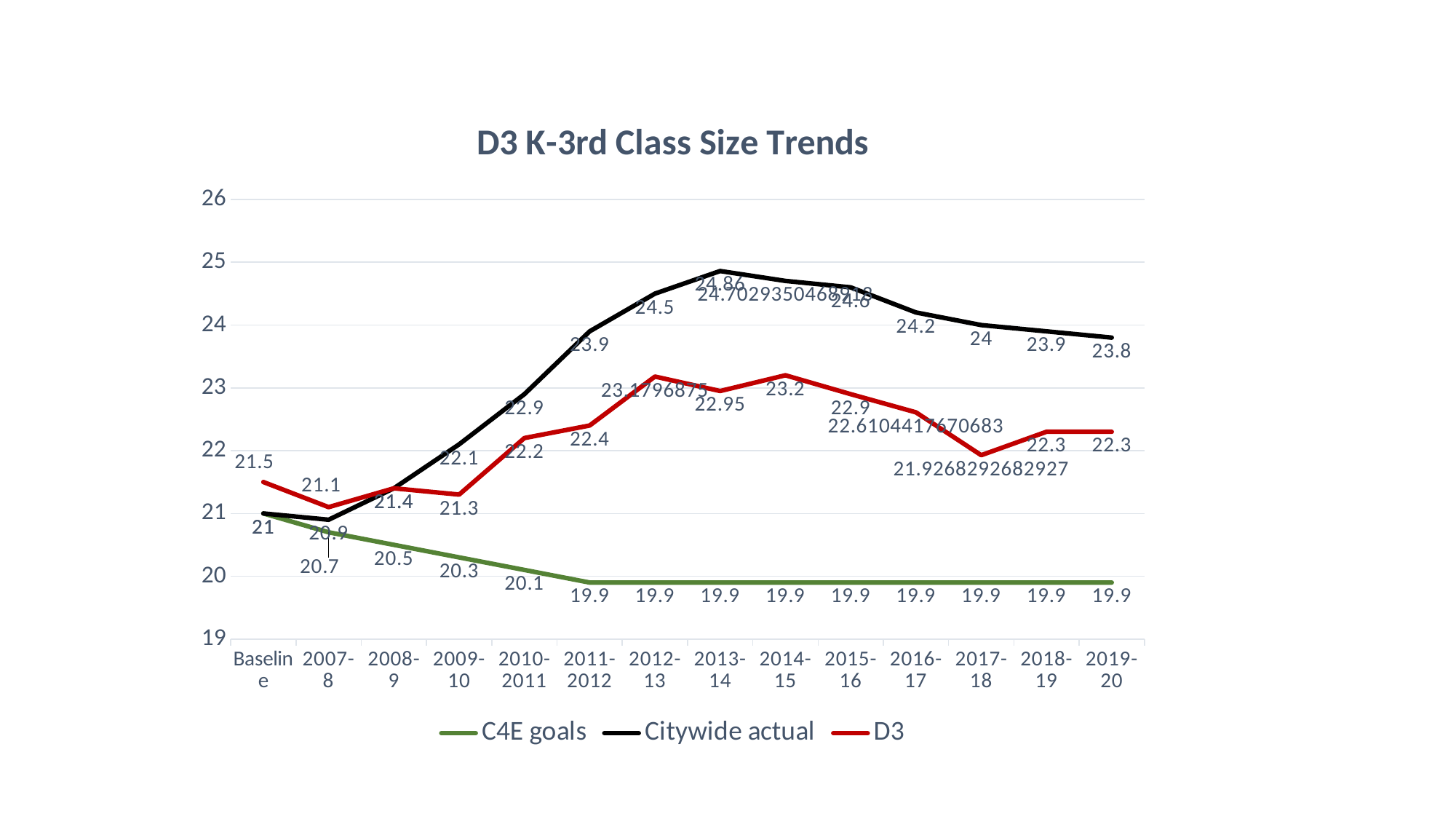
What is the C4E goals value for 2010-2011? 20.1 What is the D3 value at Baseline? 21.5 What is the Citywide actual value for 2013-14? 24.86 What is the difference between the Citywide actual and D3 values for 2019-20? 1.5 In which year does the Citywide actual series reach its highest value? 2013-14 Does the Citywide actual series rise or fall from 2013-14 to 2019-20? fall Which is larger in 2012-13, the Citywide actual value or the D3 value? Citywide actual What type of chart is shown on the slide? line chart Is the Citywide actual value for 2014-15 greater or less than 24? greater How many points along the x axis does each series have? 14 What is the D3 value for 2019-20? 22.3 How many series does the legend list? 3